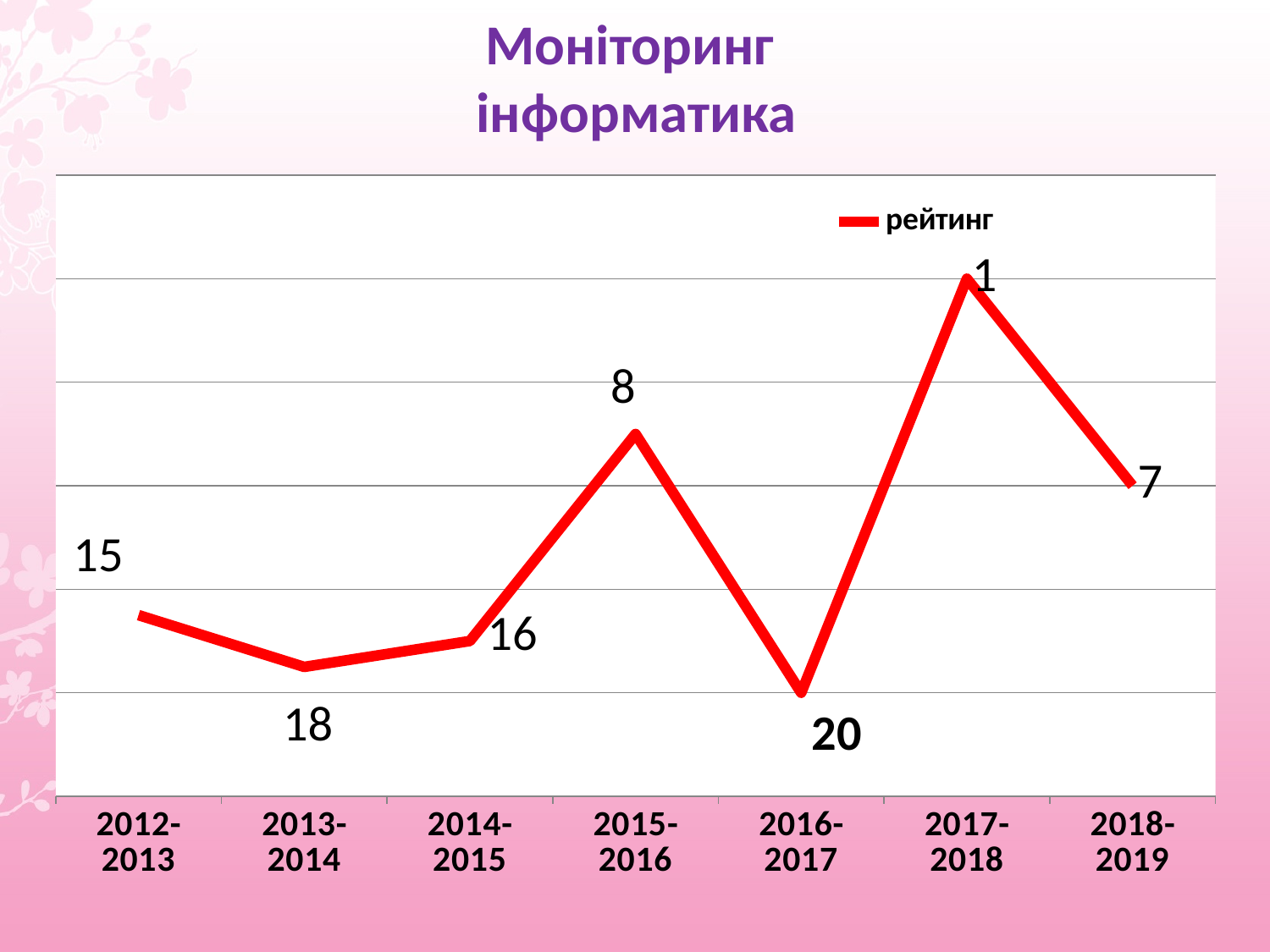
What is the value for 2013-2014? 18 What is the value for 2018-2019? 7 What is the value for 2017-2018? 1 What series name does the legend show? рейтинг Which period has the smallest numeric value? 2017-2018 Which is numerically larger, the value for 2014-2015 or the value for 2015-2016? 2014-2015 What kind of chart is shown? line chart What is the value for 2012-2013? 15 How many periods are plotted on the x axis? 7 Which period has the largest numeric value? 2016-2017 What is the value for 2015-2016? 8 What is the difference between the values for 2016-2017 and 2017-2018? 19